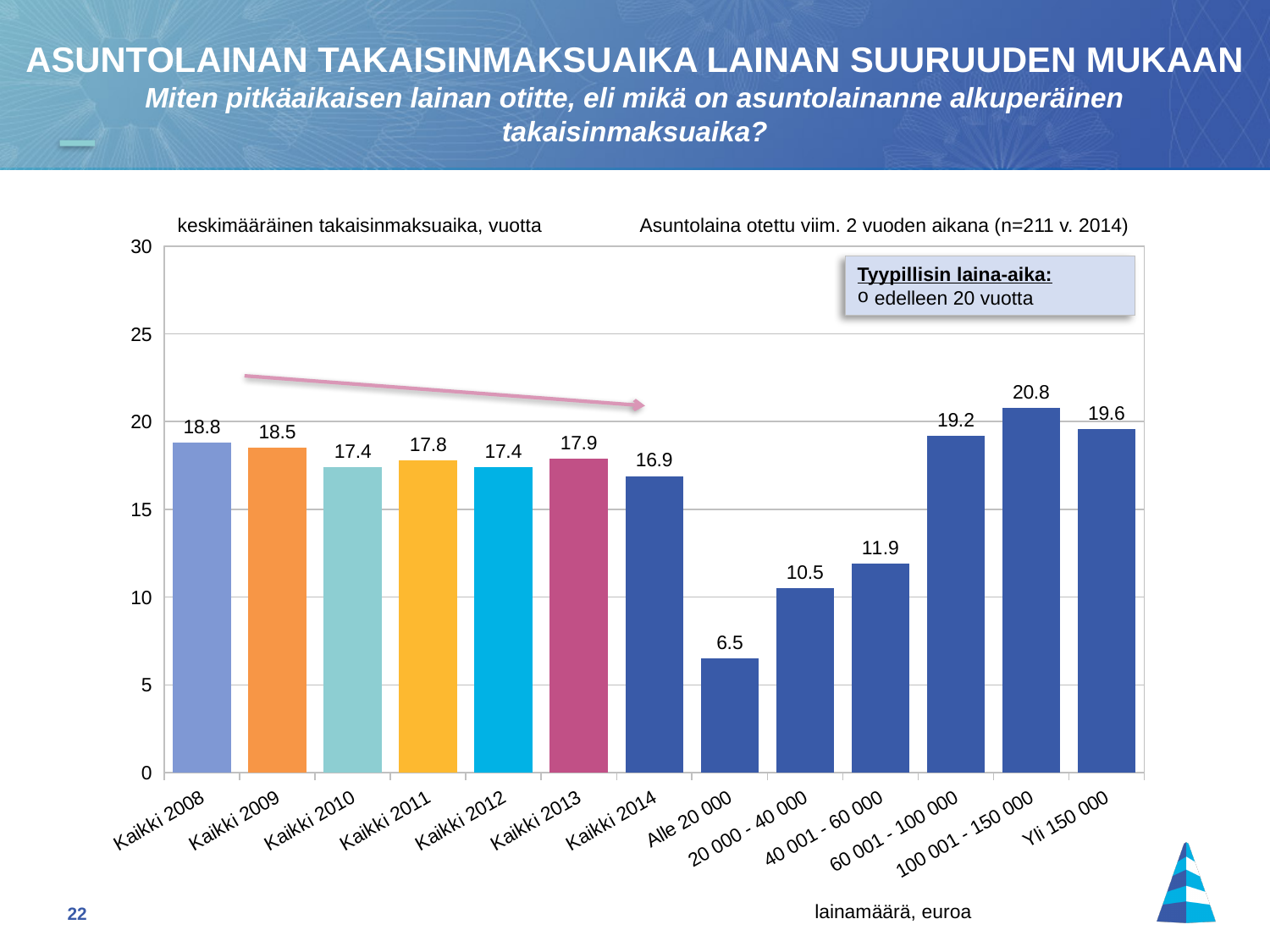
Which category has the highest value in the chart? 100 001 - 150 000 Is the value for 60 001 - 100 000 greater or less than 15? greater How many categories are shown on the x axis of the chart? 13 What value is shown for Kaikki 2008? 18.8 What is the label of the y axis of the chart? keskimääräinen takaisinmaksuaika, vuotta Which category has the lowest value in the chart? Alle 20 000 What is the difference between the values for Yli 150 000 and 40 001 - 60 000? 7.7 What value is shown for the loan amount category Alle 20 000? 6.5 Which is larger, the value for Kaikki 2009 or the value for Kaikki 2013? Kaikki 2009 What is the average repayment period shown for Kaikki 2014? 16.9 What value is shown for the 100 001 - 150 000 loan amount category? 20.8 What kind of chart is shown on the slide? bar chart